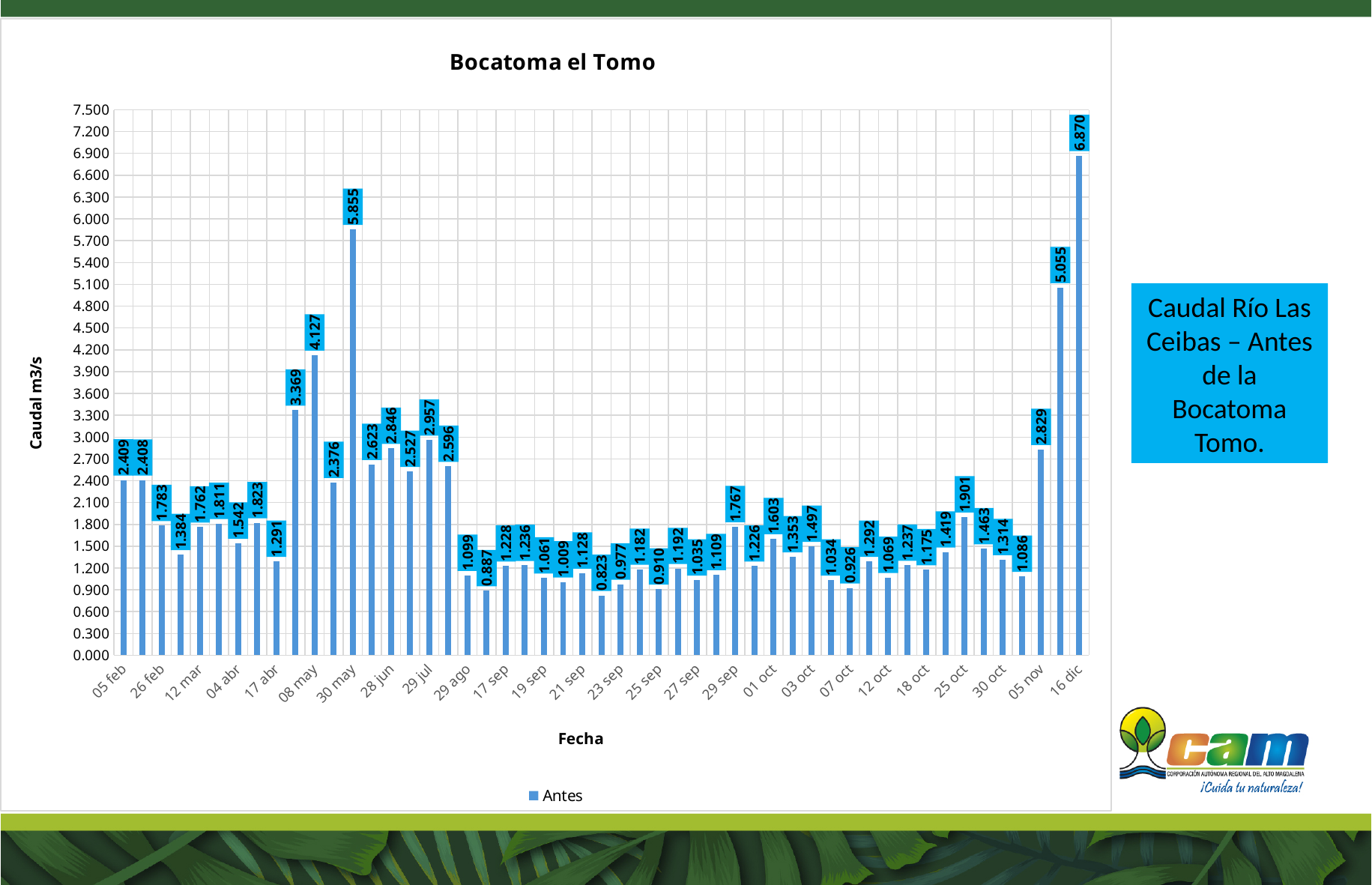
What is the lowest value shown in the chart? 0.823 Which is larger, the value for 08 may or the value for 30 may? 30 may What is the value for 16 dic? 6.870 What is the title of the chart? Bocatoma el Tomo How many series does the legend list? 1 What is the value for 08 may? 4.127 Is the value for 05 nov greater or less than 2.400? greater Which date has the highest value? 16 dic What is the value for 05 feb? 2.409 What is the difference between the values for 16 dic and 30 may? 1.015 What type of chart is shown on the slide? bar chart What is the value for 30 may? 5.855